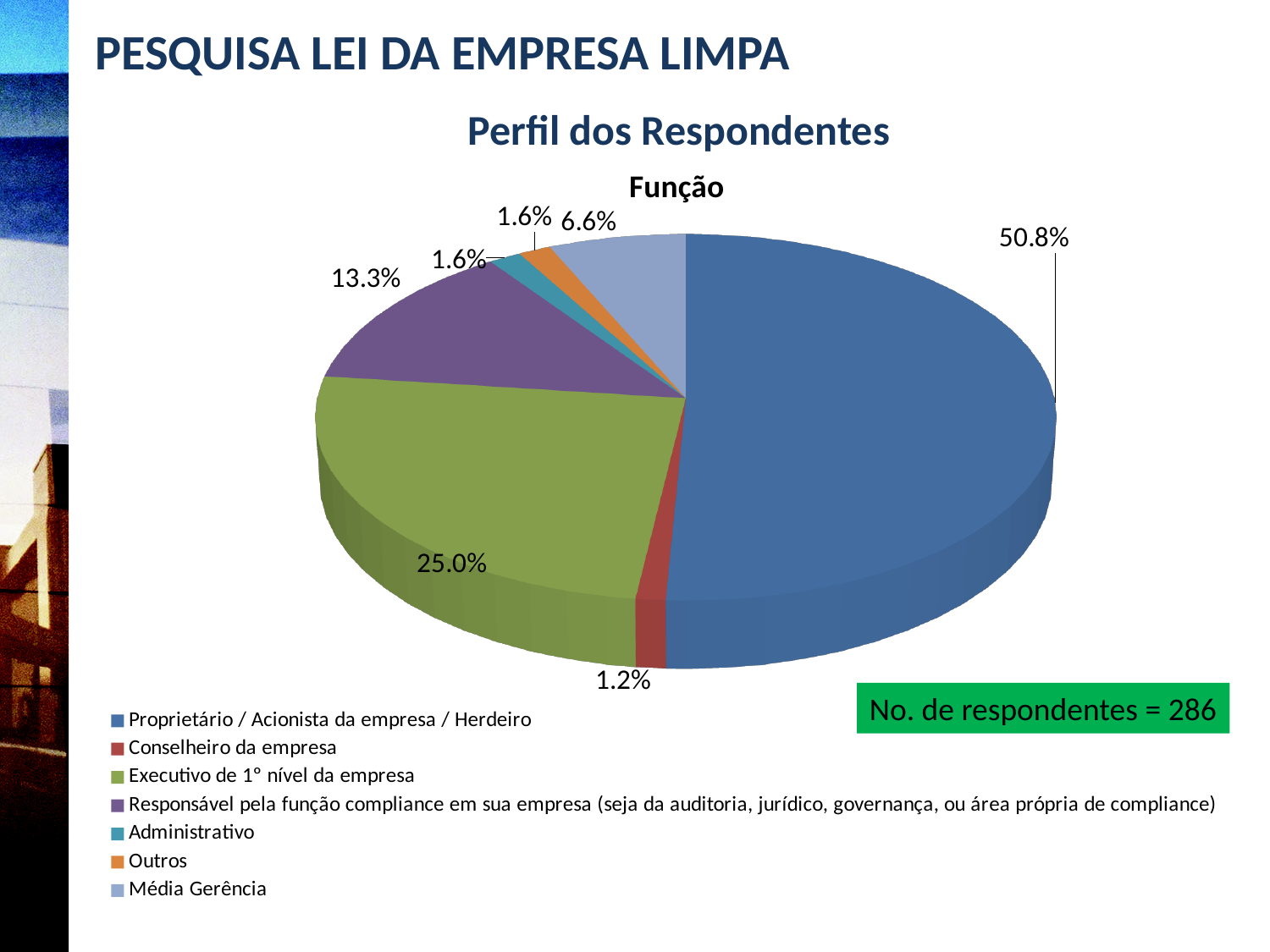
Which category has the smallest share of the pie? Conselheiro da empresa What type of chart is shown on the slide? pie chart What percentage of respondents are Responsável pela função compliance em sua empresa? 13.3% What percentage of respondents are Executivo de 1° nível da empresa? 25.0% What is the difference in percentage points between Proprietário / Acionista da empresa / Herdeiro and Executivo de 1° nível da empresa? 25.8 What percentage of respondents are Média Gerência? 6.6% What percentage of respondents are Proprietário / Acionista da empresa / Herdeiro? 50.8% How many categories does the legend list? 7 Which category has the largest share of the pie? Proprietário / Acionista da empresa / Herdeiro Which is larger, the share for Responsável pela função compliance or the share for Média Gerência? Responsável pela função compliance em sua empresa What percentage of respondents are Conselheiro da empresa? 1.2% What is the title of the pie chart? Função